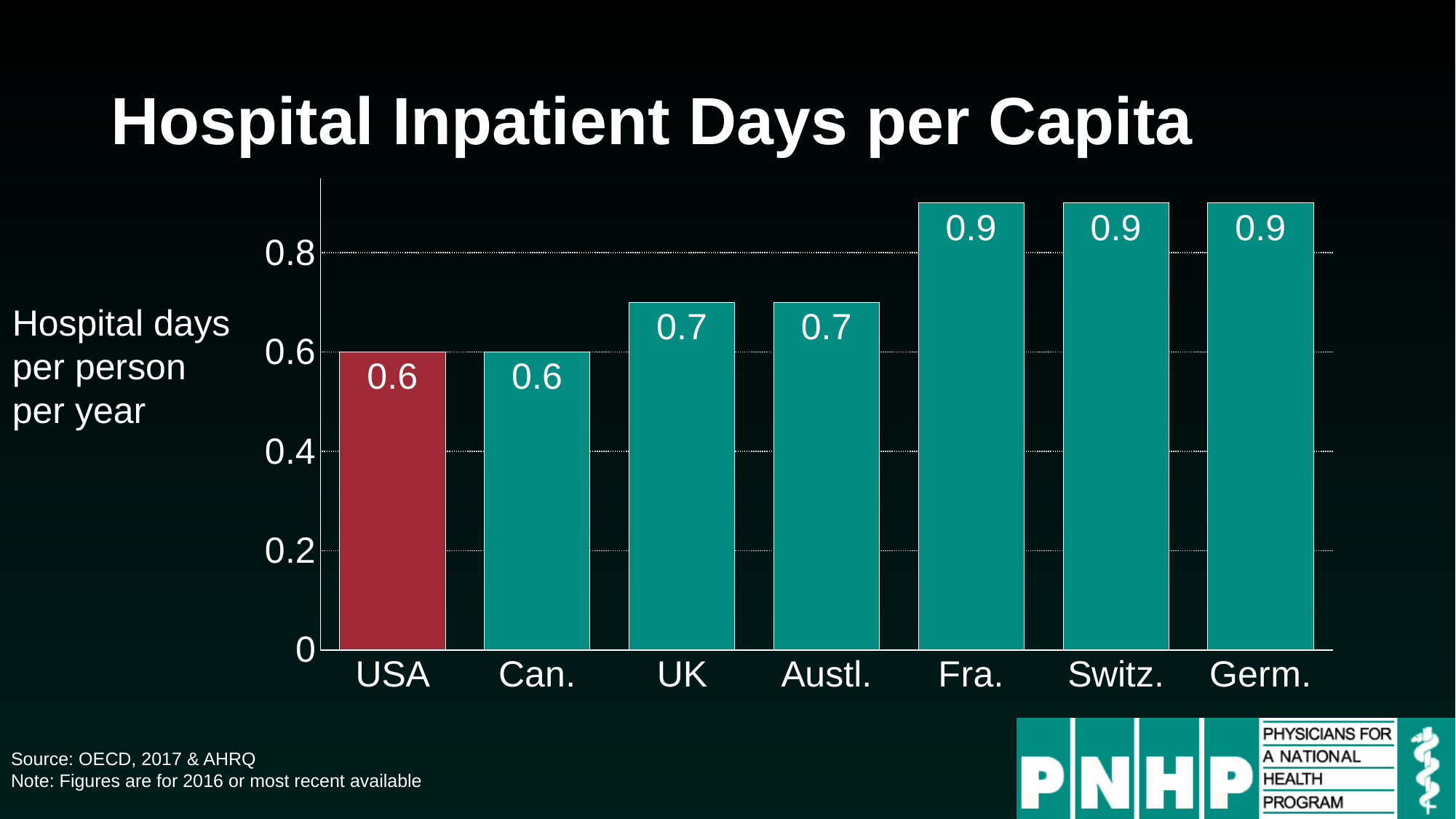
Which is larger, the value for the USA or the value for the UK? UK What is the value for the USA? 0.6 Is the value for Germ. greater or less than 0.8? greater What is the value for Fra.? 0.9 What kind of chart is shown on the slide? Bar chart What is the difference between the values for Austl. and Can.? 0.1 What is the value for the UK? 0.7 What is the difference between the values for Fra. and the USA? 0.3 Which is larger, the value for Switz. or the value for Can.? Switz. What is the value for Germ.? 0.9 Which country's bar is shown in a different colour (red) from the others? USA How many countries are shown in the chart? 7